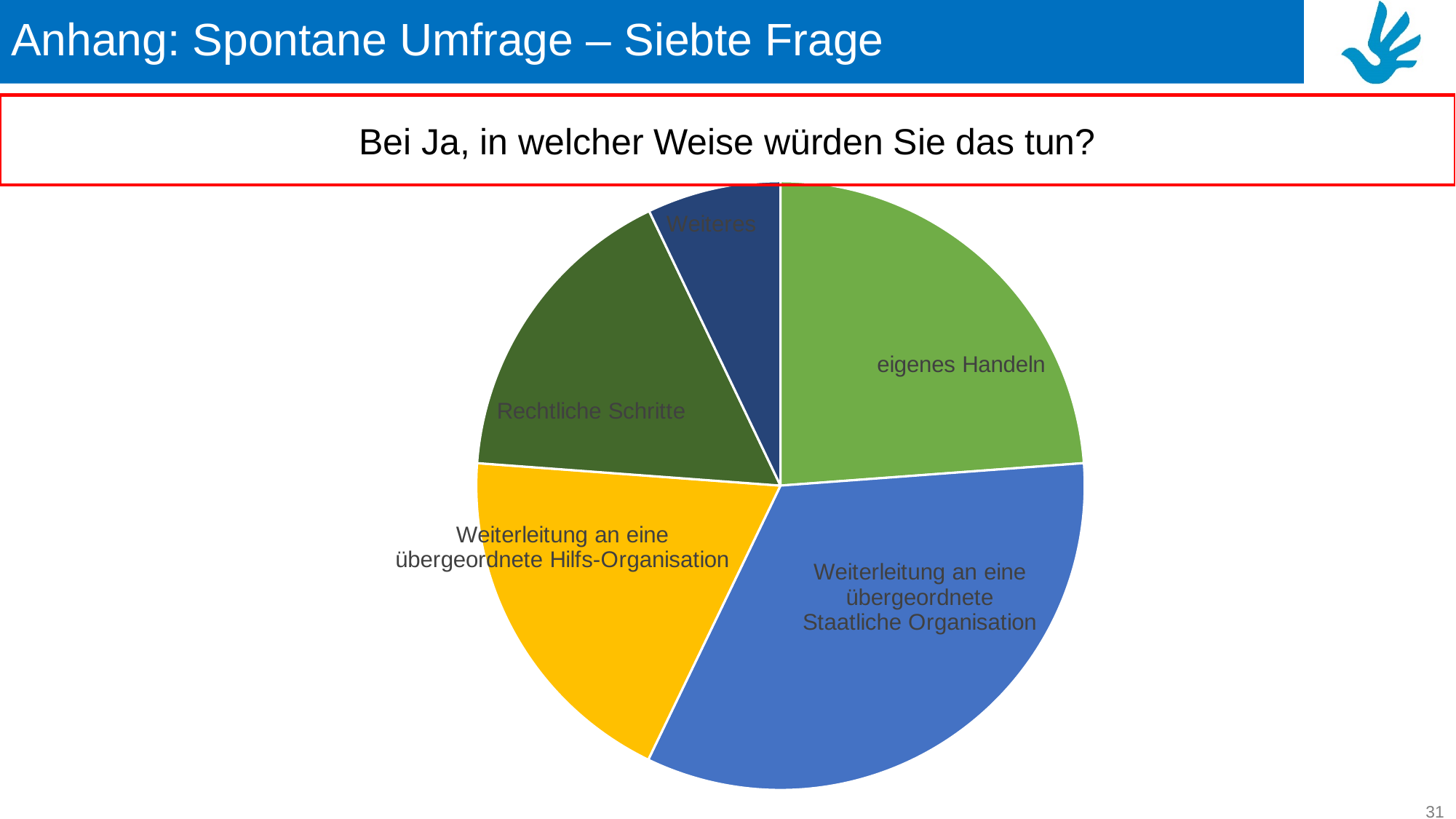
What question is the pie chart answering, as shown in the box above it? Bei Ja, in welcher Weise würden Sie das tun? Which slice is larger: eigenes Handeln or Rechtliche Schritte? eigenes Handeln Which slice is larger: Weiteres or Weiterleitung an eine übergeordnete Hilfs-Organisation? Weiterleitung an eine übergeordnete Hilfs-Organisation Which slice is larger: Weiterleitung an eine übergeordnete Staatliche Organisation or eigenes Handeln? Weiterleitung an eine übergeordnete Staatliche Organisation How many slices does the pie chart have? 5 What colour is the slice labelled eigenes Handeln? green Which category has the largest slice of the pie chart? Weiterleitung an eine übergeordnete Staatliche Organisation Which category has the smallest slice of the pie chart? Weiteres What kind of chart is shown on the slide? pie chart